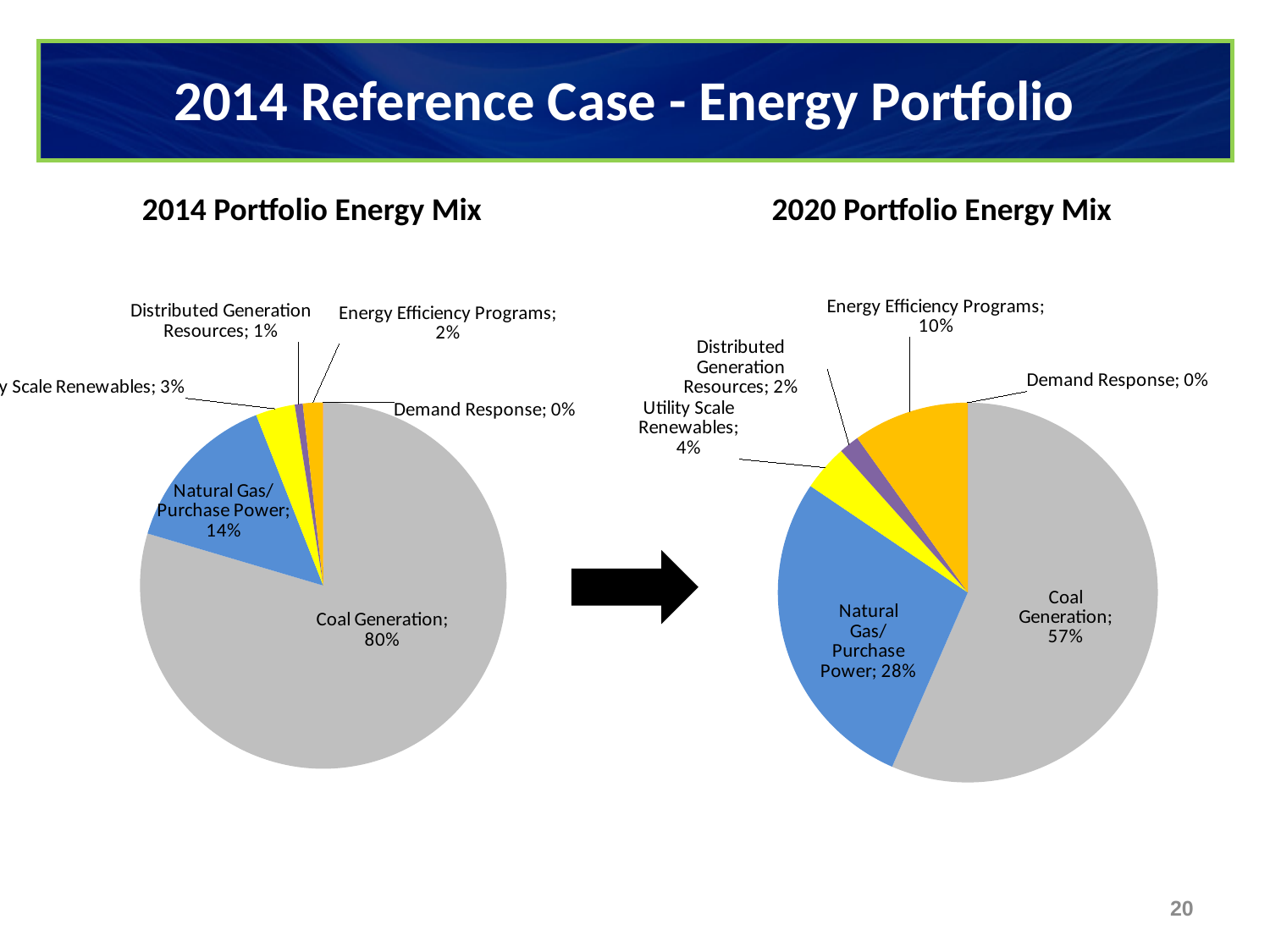
In the 2014 Portfolio Energy Mix chart, what share do Distributed Generation Resources have? 1% In the 2020 Portfolio Energy Mix chart, what share does Natural Gas/Purchase Power have? 28% In the 2020 Portfolio Energy Mix chart, what share do Utility Scale Renewables have? 4% In the 2020 Portfolio Energy Mix chart, what share do Energy Efficiency Programs have? 10% How many categories are shown in the 2020 Portfolio Energy Mix chart? 6 In the 2014 Portfolio Energy Mix chart, what share does Coal Generation have? 80% What type of chart is the 2014 Portfolio Energy Mix chart? Pie chart In the 2020 Portfolio Energy Mix chart, which category has the smallest share? Demand Response In the 2014 Portfolio Energy Mix chart, which category has the largest share? Coal Generation In the 2020 Portfolio Energy Mix chart, what is the difference between the Coal Generation share and the Natural Gas/Purchase Power share? 29 percentage points Which is larger: the Energy Efficiency Programs share in the 2014 Portfolio Energy Mix chart or in the 2020 Portfolio Energy Mix chart? 2020 Portfolio Energy Mix What is the difference between the Coal Generation share in the 2014 Portfolio Energy Mix chart and in the 2020 Portfolio Energy Mix chart? 23 percentage points